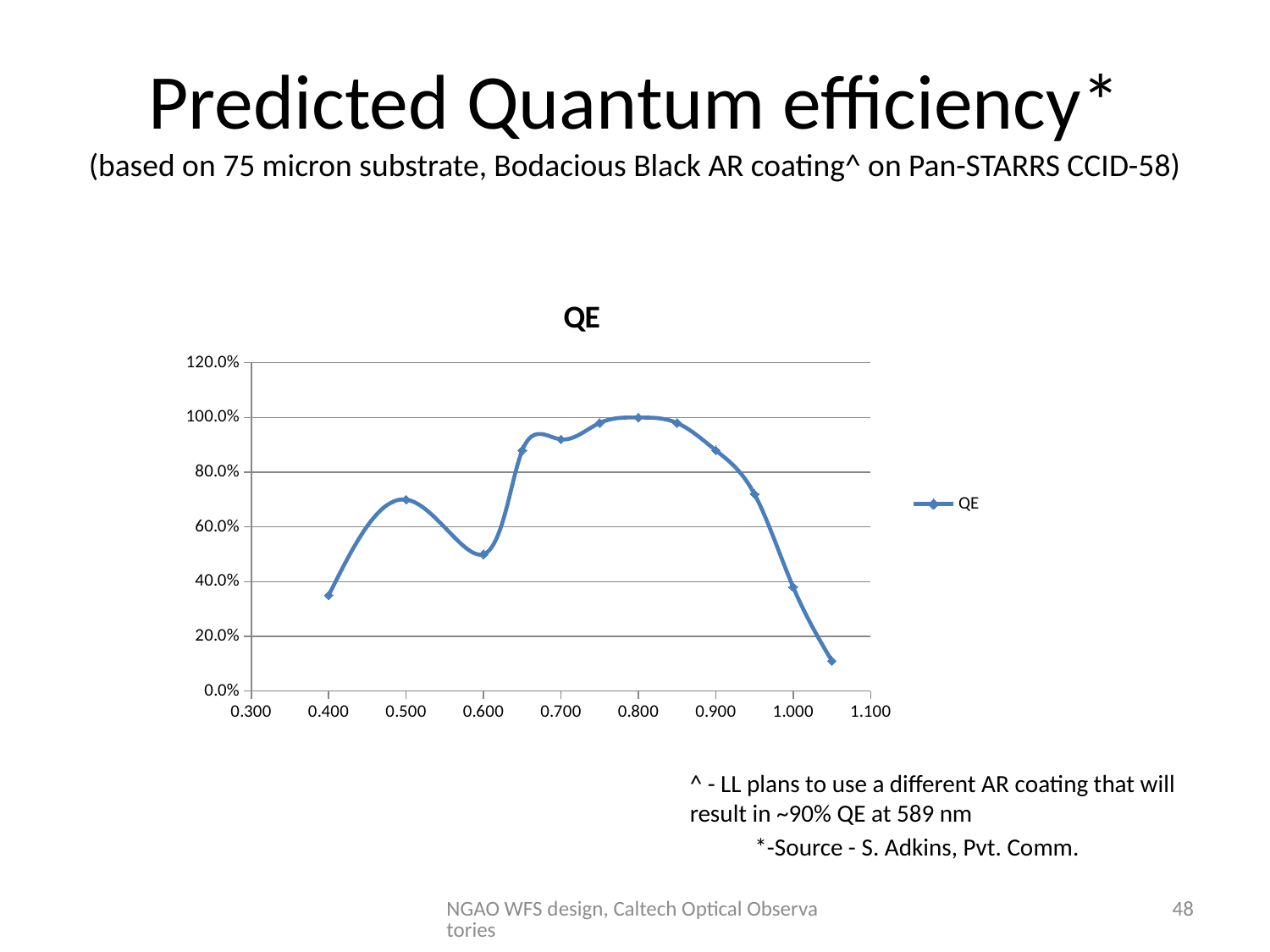
Is the QE value at 0.500 greater or less than 60.0%? greater Is the QE value at 0.400 greater or less than 40.0%? less Does the QE value rise or fall along the x axis from 0.800 to 1.050? fall Which has the higher QE value, 0.500 or 0.600? 0.500 What is the title of the chart? QE How many data points are plotted on the QE line? 12 How many series does the legend list? 1 At which x value does the QE line reach its highest point? 0.800 Is the QE value at 0.900 greater or less than 80.0%? greater What kind of chart is shown on the slide? line chart